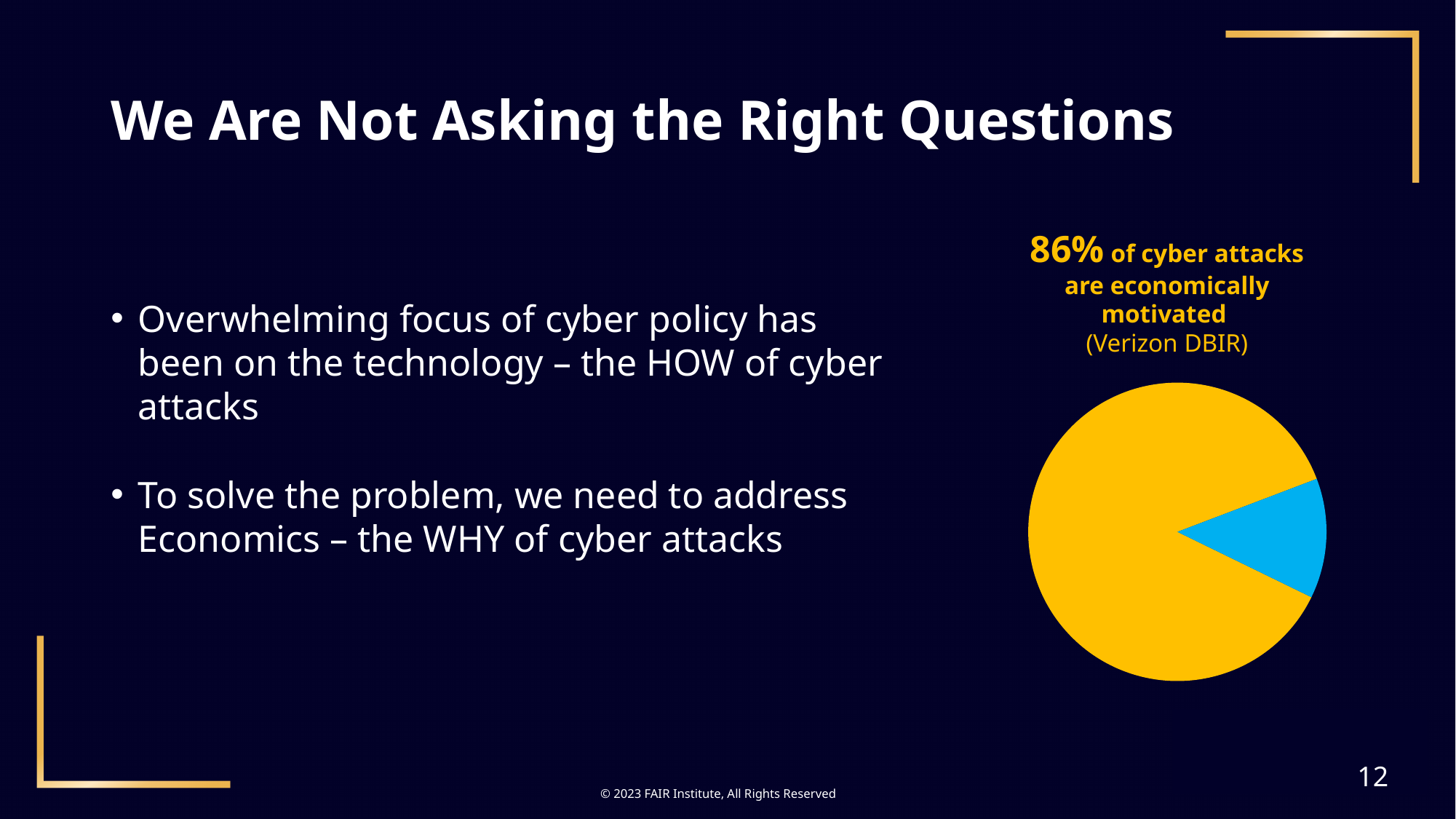
Which slice of the pie chart is larger, the yellow slice or the blue slice? the yellow slice What share of cyber attacks does the pie chart show as economically motivated? 86% How many slices does the pie chart have? 2 Which slice of the pie chart is the smallest? the blue slice Which slice of the pie chart is the largest? the yellow slice What kind of chart is shown on the slide? pie chart What source is cited for the pie chart's 86% figure? Verizon DBIR What colour is the slice representing economically motivated cyber attacks? yellow